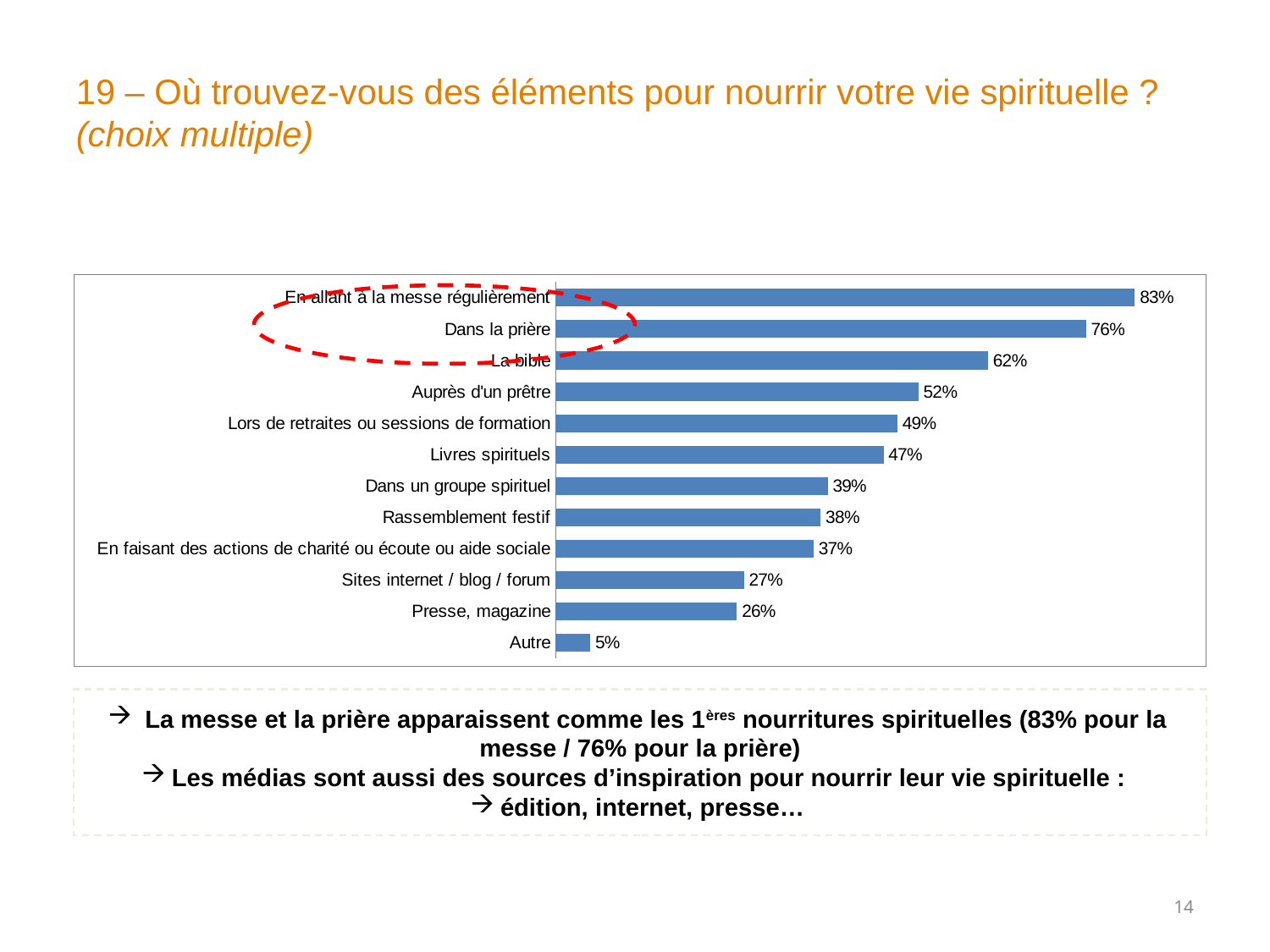
Which category is circled with a red dashed line on the chart? En allant à la messe régulièrement and Dans la prière What is the difference between "En allant à la messe régulièrement" and "Dans la prière"? 7% What is the value for "Dans la prière"? 76% Which category has the lowest value? Autre What is the value for "Auprès d'un prêtre"? 52% How many categories are shown in the chart? 12 What is the value for "Livres spirituels"? 47% What is the difference between "La bible" and "Presse, magazine"? 36% Which is larger, "Dans un groupe spirituel" or "Sites internet / blog / forum"? Dans un groupe spirituel What is the value for "Sites internet / blog / forum"? 27% What kind of chart is shown on the slide? Bar chart Which category has the highest value? En allant à la messe régulièrement